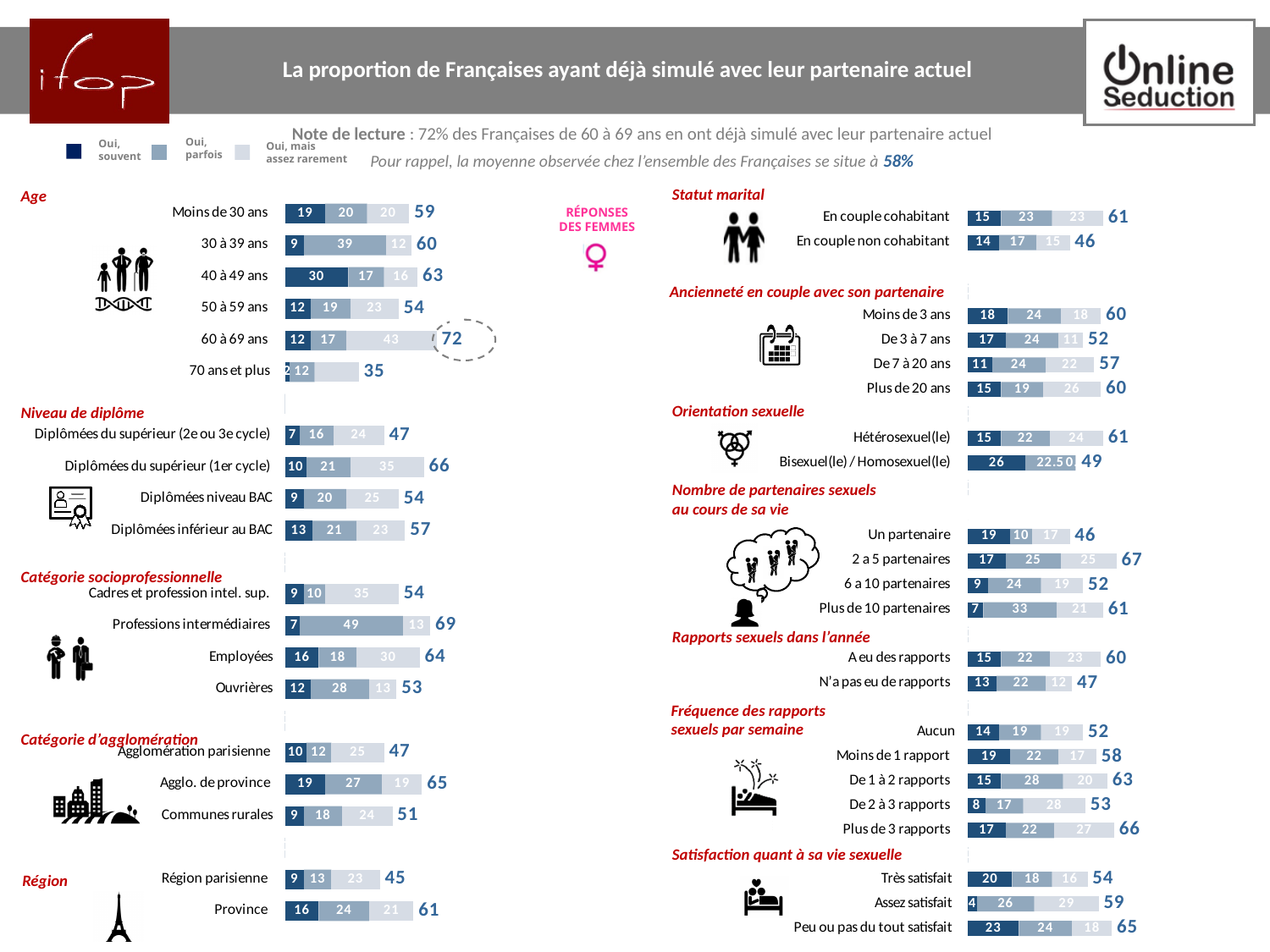
In the 'Catégorie socioprofessionnelle' chart, what is the 'Oui, parfois' value for 'Professions intermédiaires'? 49 In the 'Statut marital' chart, which has the larger total: 'En couple cohabitant' or 'En couple non cohabitant'? En couple cohabitant In the 'Nombre de partenaires sexuels au cours de sa vie' chart, what is the total for '2 a 5 partenaires'? 67 In the 'Niveau de diplôme' chart, which category has the highest total? Diplômées du supérieur (1er cycle) In the 'Région' chart, what is the difference between the totals for 'Province' and 'Région parisienne'? 16 What kind of chart is used for the 'Age' data? Stacked bar chart In the 'Satisfaction quant à sa vie sexuelle' chart, what is the 'Oui, souvent' value for 'Peu ou pas du tout satisfait'? 23 How many categories are shown in the 'Fréquence des rapports sexuels par semaine' chart? 5 How many series does the legend list? 3 In the 'Age' chart, what is the total value shown for '60 à 69 ans'? 72 In the 'Age' chart, which age group has the lowest total? 70 ans et plus In the 'Catégorie d'agglomération' chart, what is the difference between the totals for 'Agglo. de province' and 'Agglomération parisienne'? 18